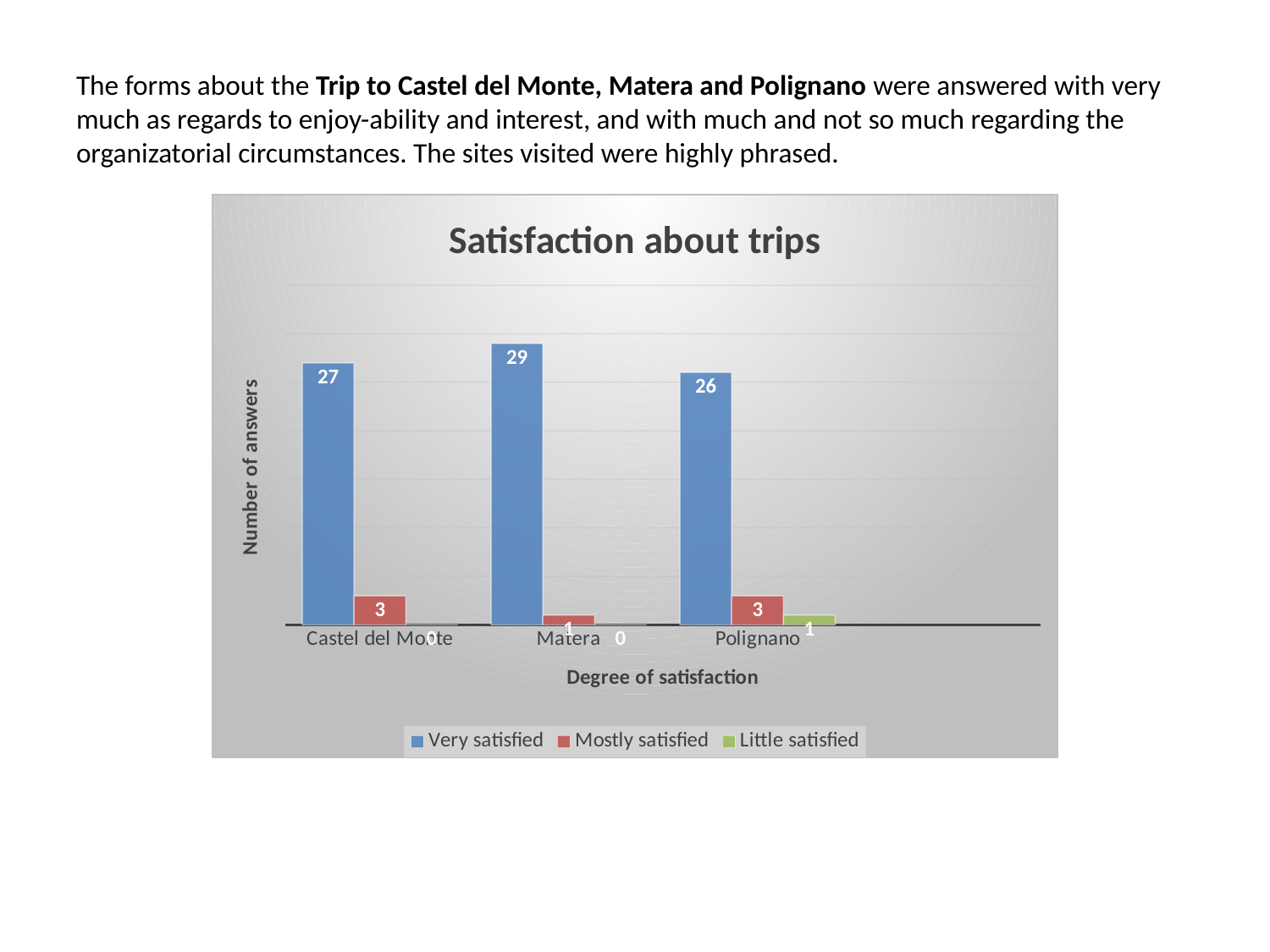
What is the title of the chart? Satisfaction about trips What type of chart is shown on the slide? bar chart Which is larger: the 'Mostly satisfied' answers for Castel del Monte or for Matera? Castel del Monte What is the number of 'Very satisfied' answers for Castel del Monte? 27 What is the number of 'Mostly satisfied' answers for Polignano? 3 Which trip has the highest number of 'Very satisfied' answers? Matera How many series does the legend list? 3 How many trip categories are shown on the x axis? 3 What is the number of 'Little satisfied' answers for Polignano? 1 What is the number of 'Very satisfied' answers for Matera? 29 What is the difference between the 'Very satisfied' answers for Matera and Polignano? 3 Which trip has the lowest number of 'Very satisfied' answers? Polignano